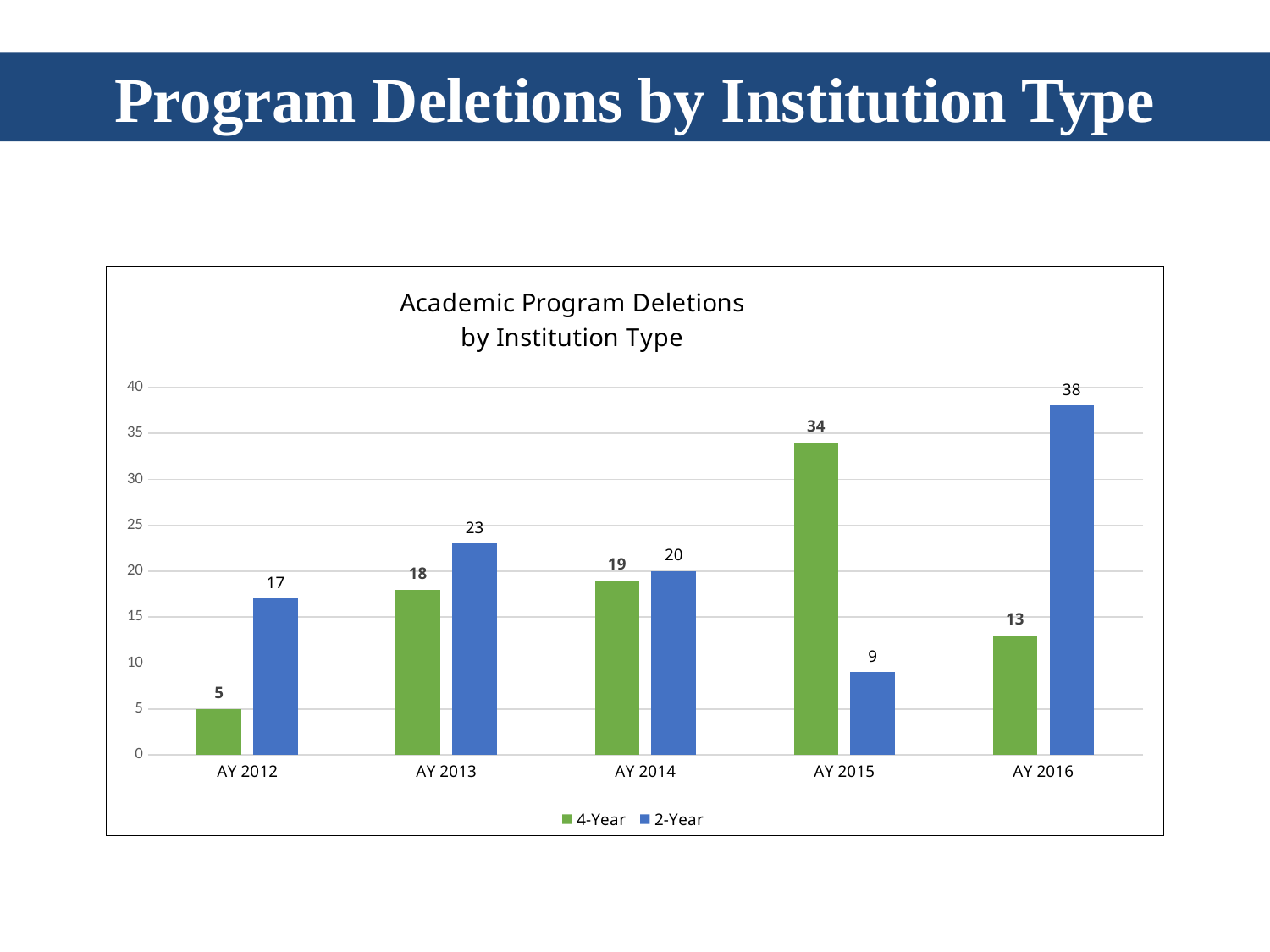
What is the title of the chart? Academic Program Deletions by Institution Type How many academic years are shown on the x axis? 5 For AY 2013, which is larger, the 4-Year value or the 2-Year value? 2-Year What is the difference between the 2-Year and 4-Year values for AY 2015? 25 Which academic year has the lowest 4-Year value? AY 2012 Is the 2-Year value for AY 2014 greater or less than 15? greater What kind of chart is shown on the slide? bar chart Which academic year has the highest 2-Year value? AY 2016 What is the 4-Year value for AY 2012? 5 How many series does the legend list? 2 What is the 2-Year value for AY 2016? 38 What is the 4-Year value for AY 2015? 34